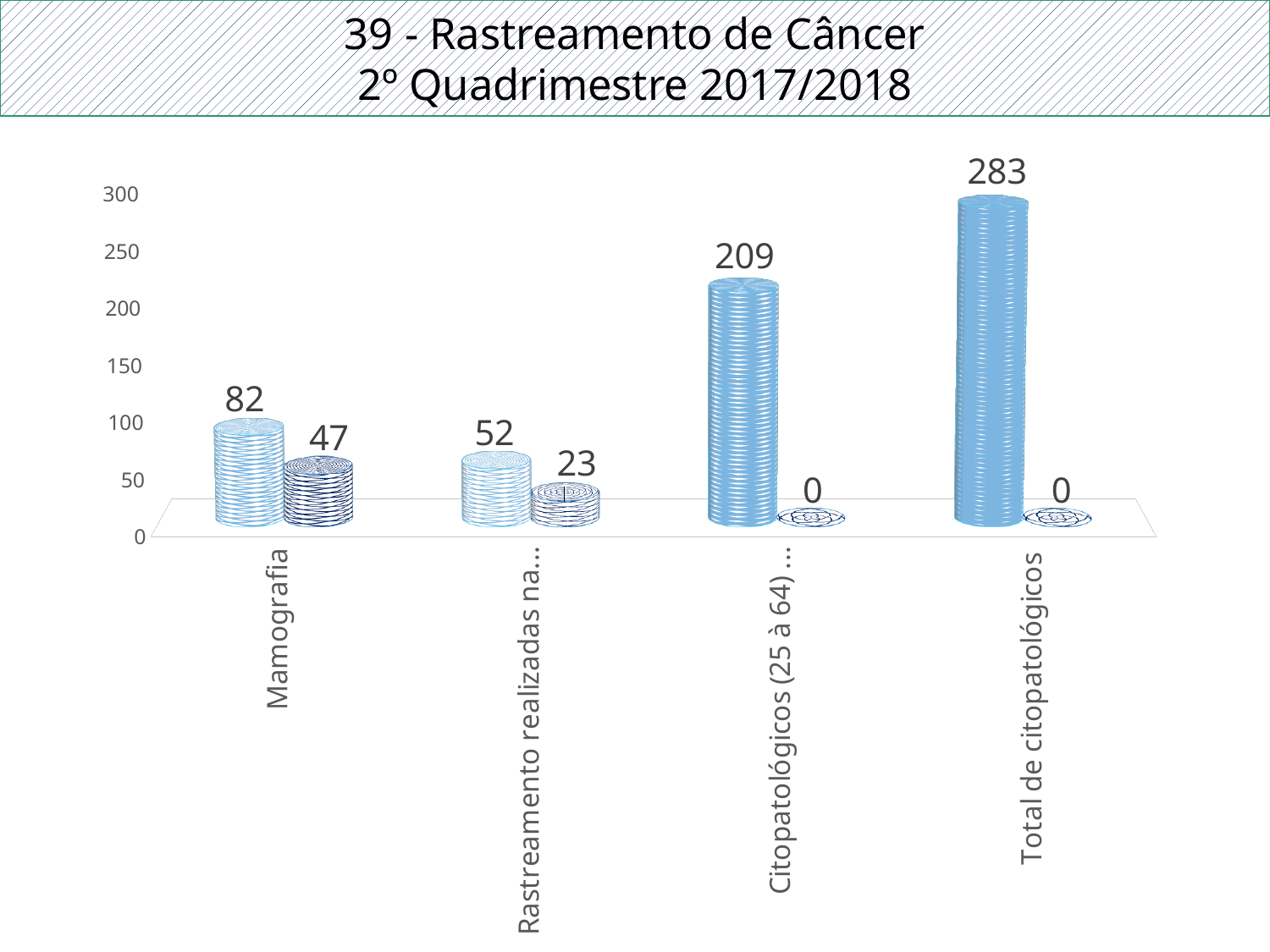
What is the difference between the light blue and dark blue bars for Mamografia? 35 What kind of chart is shown on the slide? bar chart What is the value of the dark blue bar for Total de citopatológicos? 0 Which category has the highest light blue bar? Total de citopatológicos What is the difference between the light blue bar for Total de citopatológicos and the light blue bar of the third category from the left? 74 Is the light blue bar for Mamografia greater or less than 100? less What is the value of the light blue bar for Total de citopatológicos? 283 Which is larger: the light blue bar for Mamografia or the light blue bar for Total de citopatológicos? Total de citopatológicos What is the title of the slide? 39 - Rastreamento de Câncer 2º Quadrimestre 2017/2018 How many categories are shown on the x axis? 4 What is the value of the light blue bar for Mamografia? 82 What is the value of the dark blue bar for Mamografia? 47